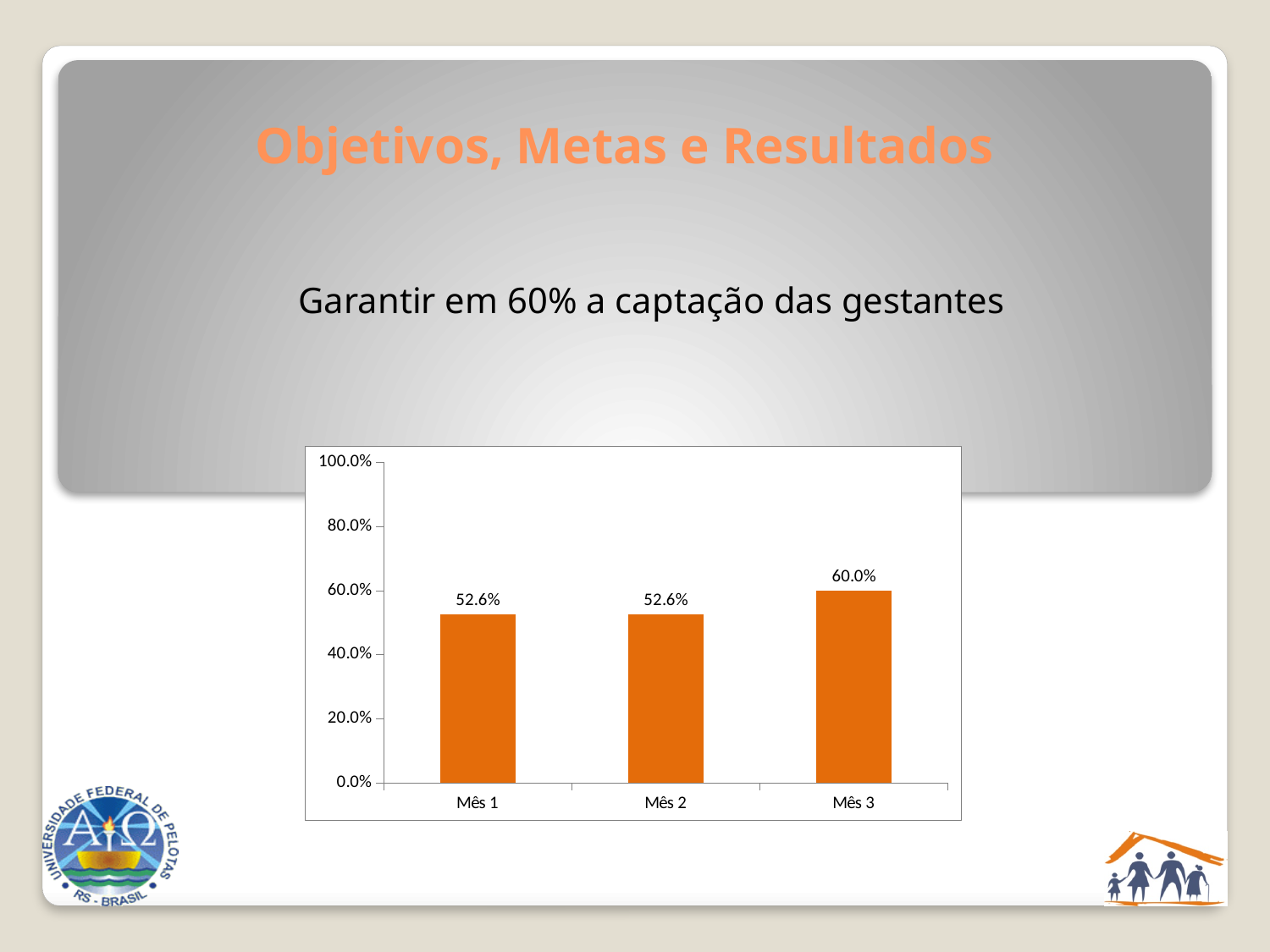
Which month has the highest value? Mês 3 What colour are the bars in the chart? orange Which is larger, the value for Mês 1 or the value for Mês 3? Mês 3 Do the values rise or fall from Mês 1 to Mês 3? rise What is the difference between the values for Mês 3 and Mês 2? 7.4% What is the value for Mês 1? 52.6% What kind of chart is shown on the slide? bar chart What is the value for Mês 3? 60.0% Is the value for Mês 2 greater or less than 80.0%? less What is the highest value shown on the y axis? 100.0% Are the values for Mês 1 and Mês 2 the same? yes How many months are shown on the x axis? 3